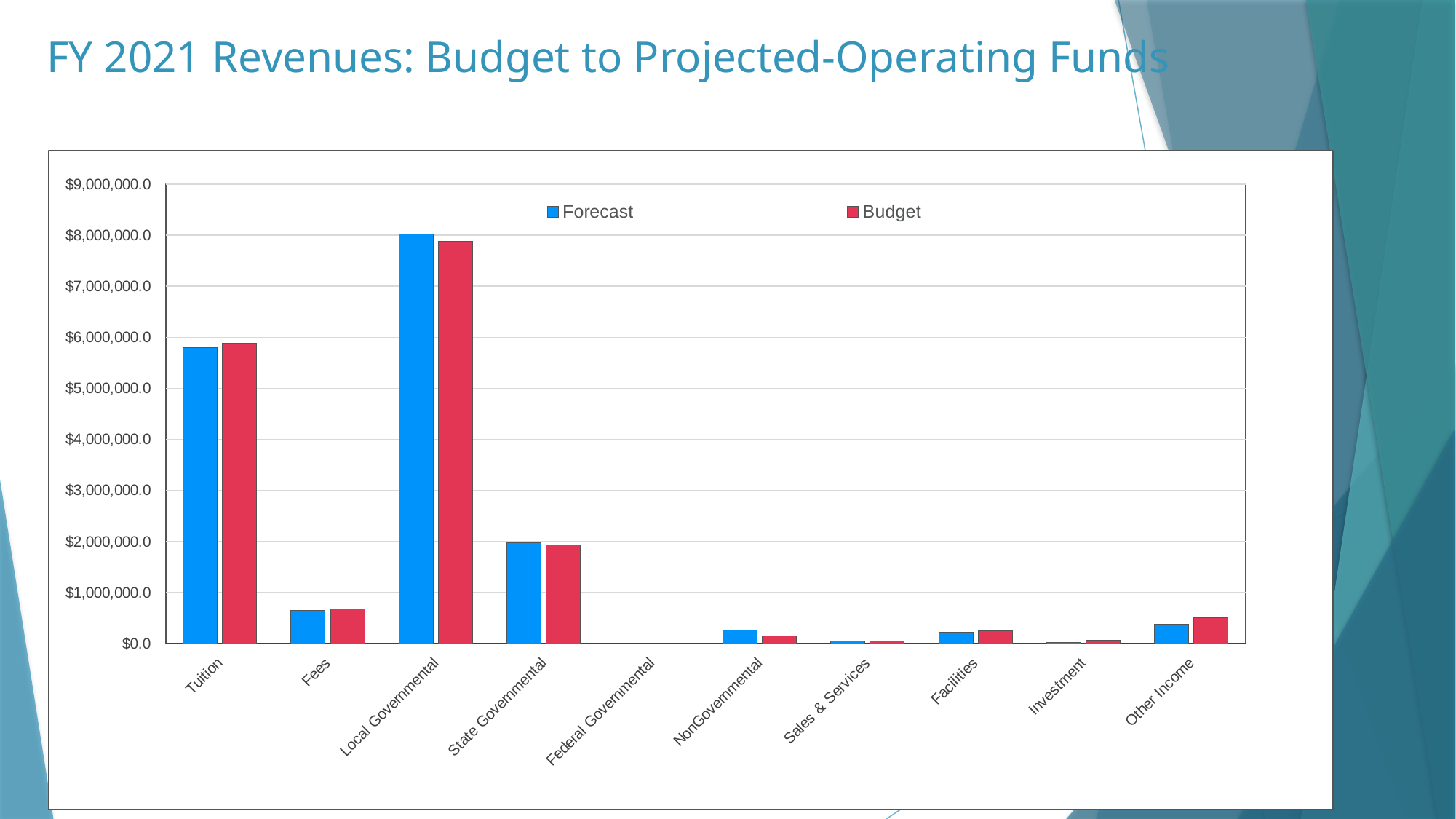
Which category has the highest Budget value? Local Governmental For Local Governmental, which is larger, the Forecast or the Budget value? Forecast Which category has the lowest Budget value? Federal Governmental Is the Forecast value for Fees greater or less than $1,000,000.0? less Which series is shown in red in the legend? Budget How many series does the legend list? 2 For Tuition, which is larger, the Forecast or the Budget value? Budget Is the Forecast value for Tuition greater or less than $5,000,000.0? greater Which category has the highest Forecast value? Local Governmental How many revenue categories are shown on the x axis? 10 What kind of chart is shown on the slide? bar chart For NonGovernmental, which is larger, the Forecast or the Budget value? Forecast